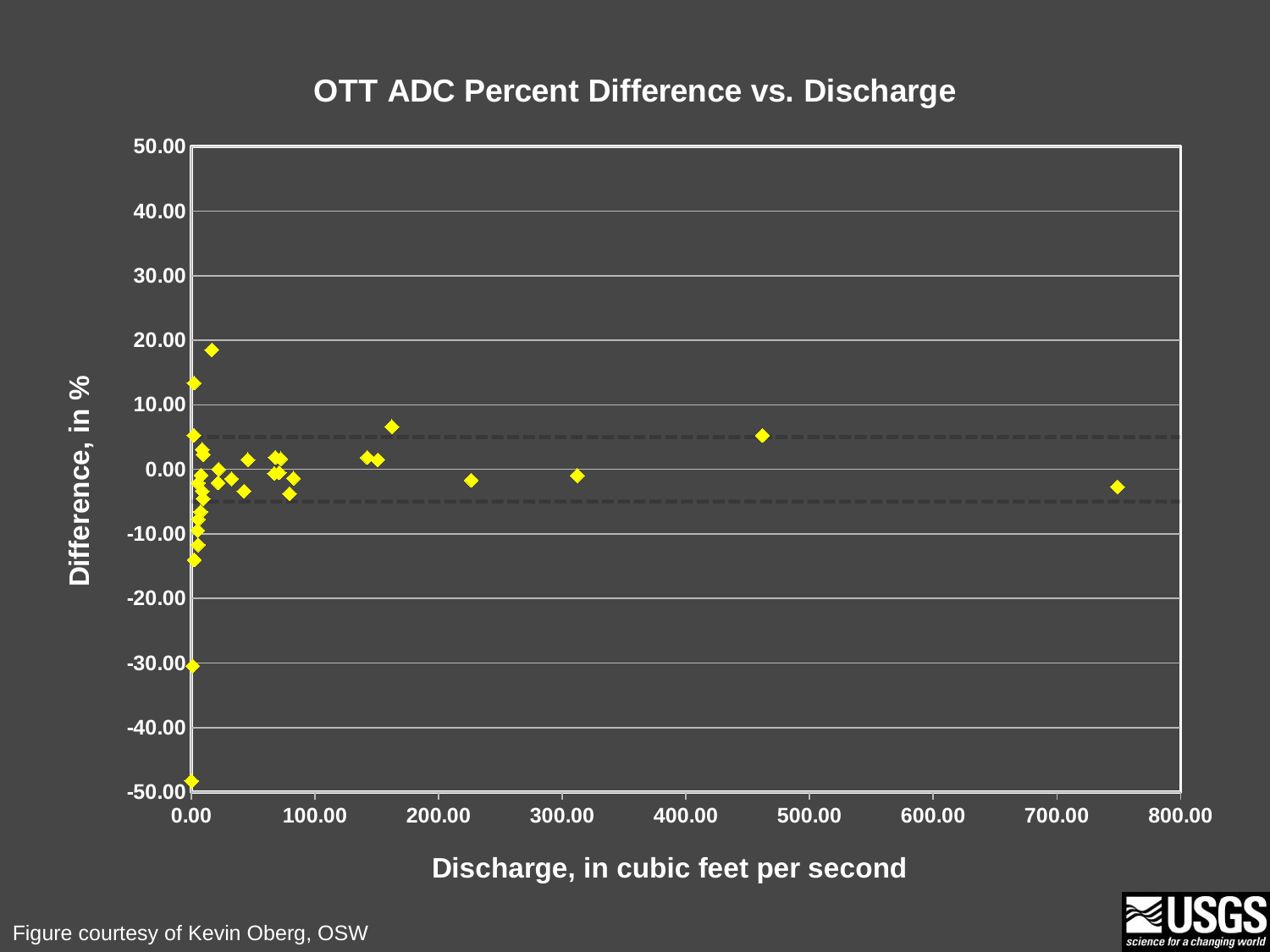
Is the difference for the point at roughly 160 cubic feet per second greater or less than 0.00? greater What kind of chart is shown on the slide? scatter chart Is the difference for the point at roughly 750 cubic feet per second greater or less than -10.00? greater Is the difference for the point at roughly 750 cubic feet per second greater or less than 0.00? less What is the label of the x axis? Discharge, in cubic feet per second What is the title of the chart? OTT ADC Percent Difference vs. Discharge As discharge increases along the x axis, do the plotted differences spread out more widely or cluster closer to 0.00? cluster closer to 0.00